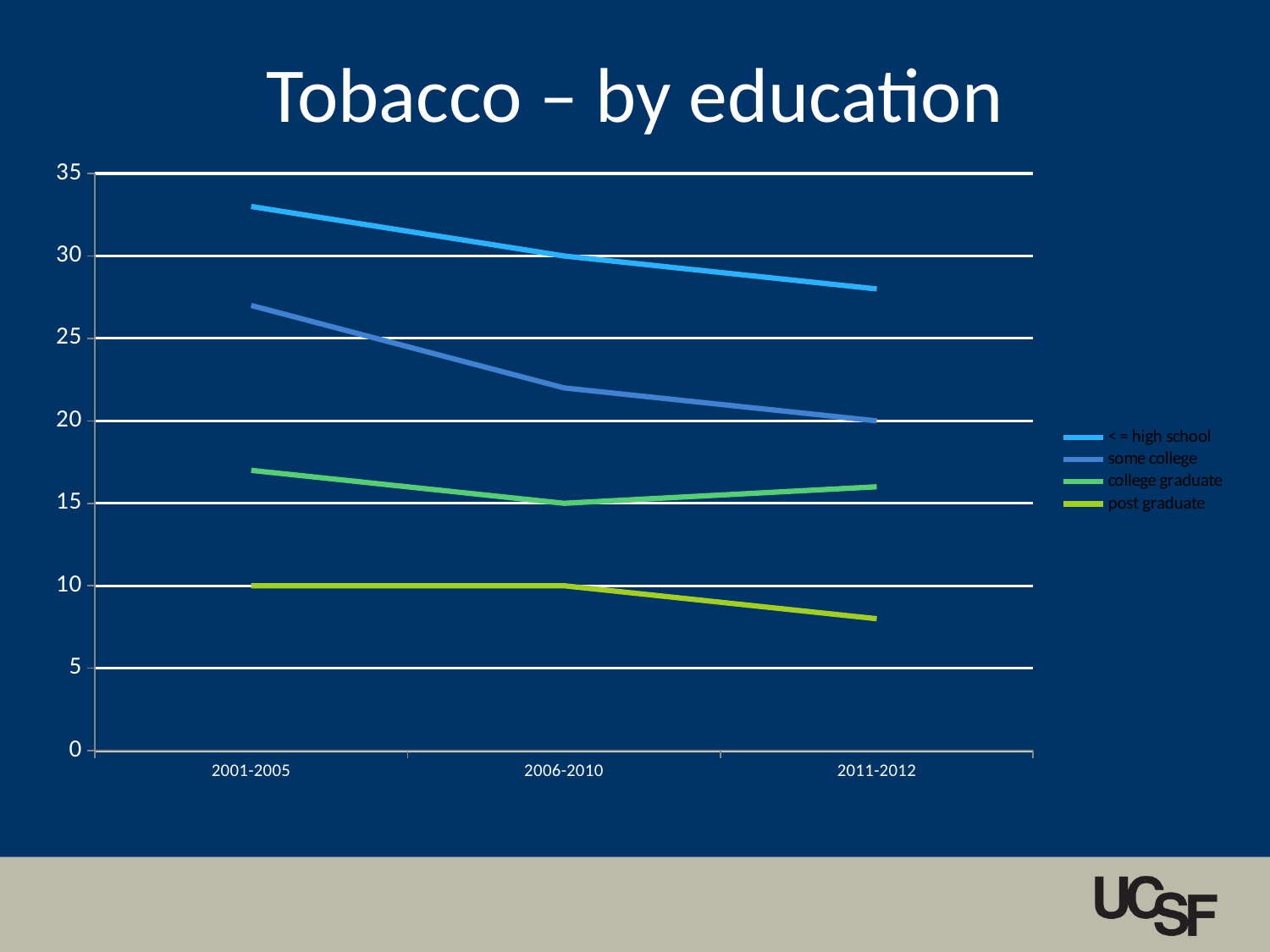
What is the value for "college graduate" in 2006-2010? 15 Is the value for "< = high school" in 2001-2005 greater or less than 30? greater How many time periods are shown on the x axis? 3 What is the value for "post graduate" in 2001-2005? 10 Is the value for "post graduate" in 2011-2012 greater or less than 10? less What kind of chart is shown on the slide? line chart Which education group has the highest value in 2011-2012? < = high school What is the value for "some college" in 2011-2012? 20 Which education group has the lowest value in 2001-2005? post graduate What is the value for "< = high school" in 2006-2010? 30 Does the "< = high school" line rise or fall from 2001-2005 to 2011-2012? fall How many series does the legend list? 4